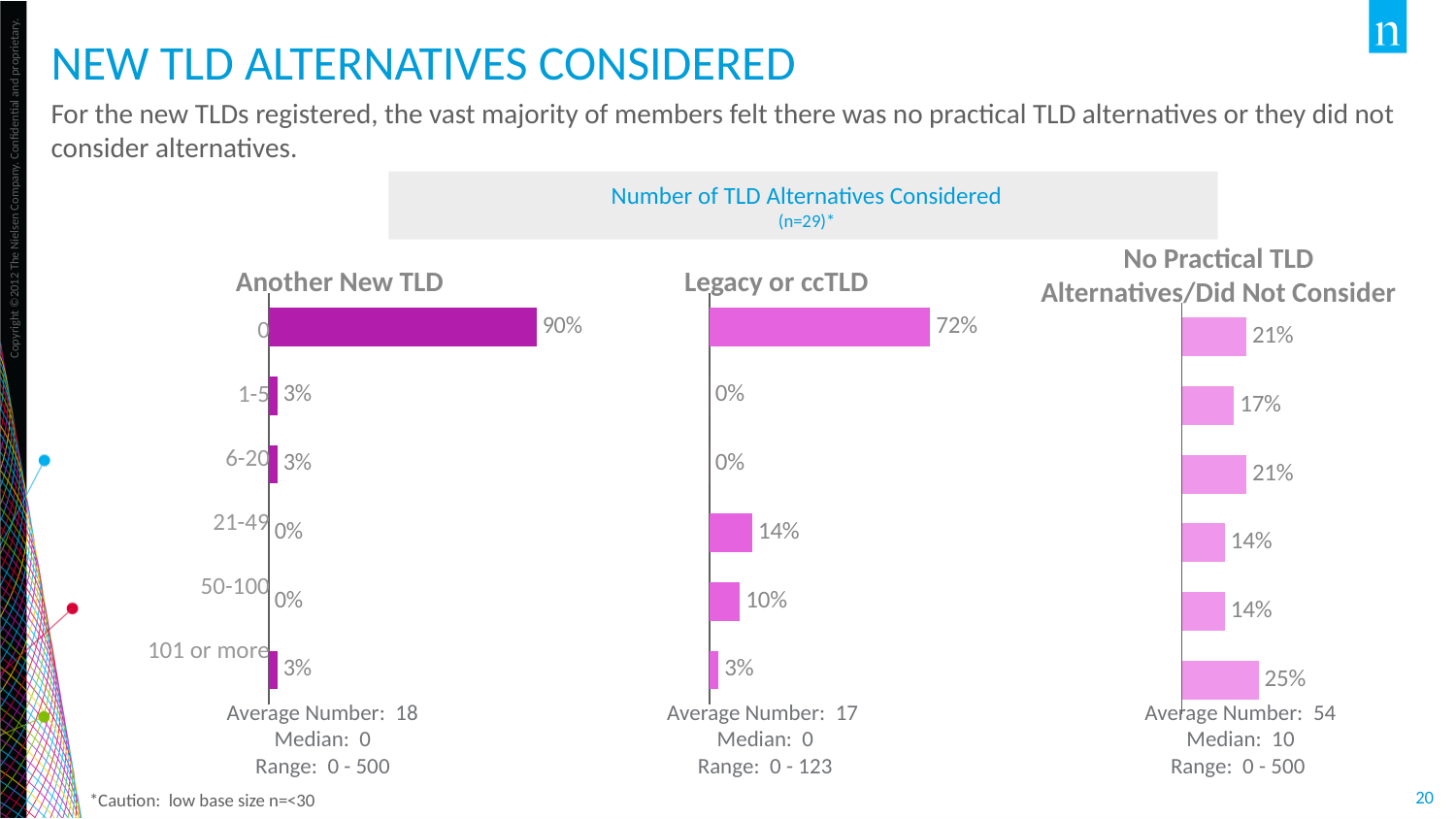
In the "No Practical TLD Alternatives/Did Not Consider" chart, what percentage is shown for the "101 or more" category? 25% In the "Another New TLD" chart, what is the difference between the "0" category and the "1-5" category? 87% In the "No Practical TLD Alternatives/Did Not Consider" chart, which category has the highest percentage? 101 or more How many categories are shown in the "Another New TLD" chart? 6 In the "Legacy or ccTLD" chart, what percentage is shown for the "21-49" category? 14% In the "No Practical TLD Alternatives/Did Not Consider" chart, which is larger: the "1-5" category or the "6-20" category? 6-20 What type of chart is the "Legacy or ccTLD" chart? Bar chart In the "Another New TLD" chart, what percentage is shown for the "0" category? 90% What is the overall title shown above the three charts? Number of TLD Alternatives Considered In the "Legacy or ccTLD" chart, what percentage is shown for the "50-100" category? 10% In the "Legacy or ccTLD" chart, which category has the highest percentage? 0 In the "Legacy or ccTLD" chart, what is the difference between the "21-49" category and the "50-100" category? 4%